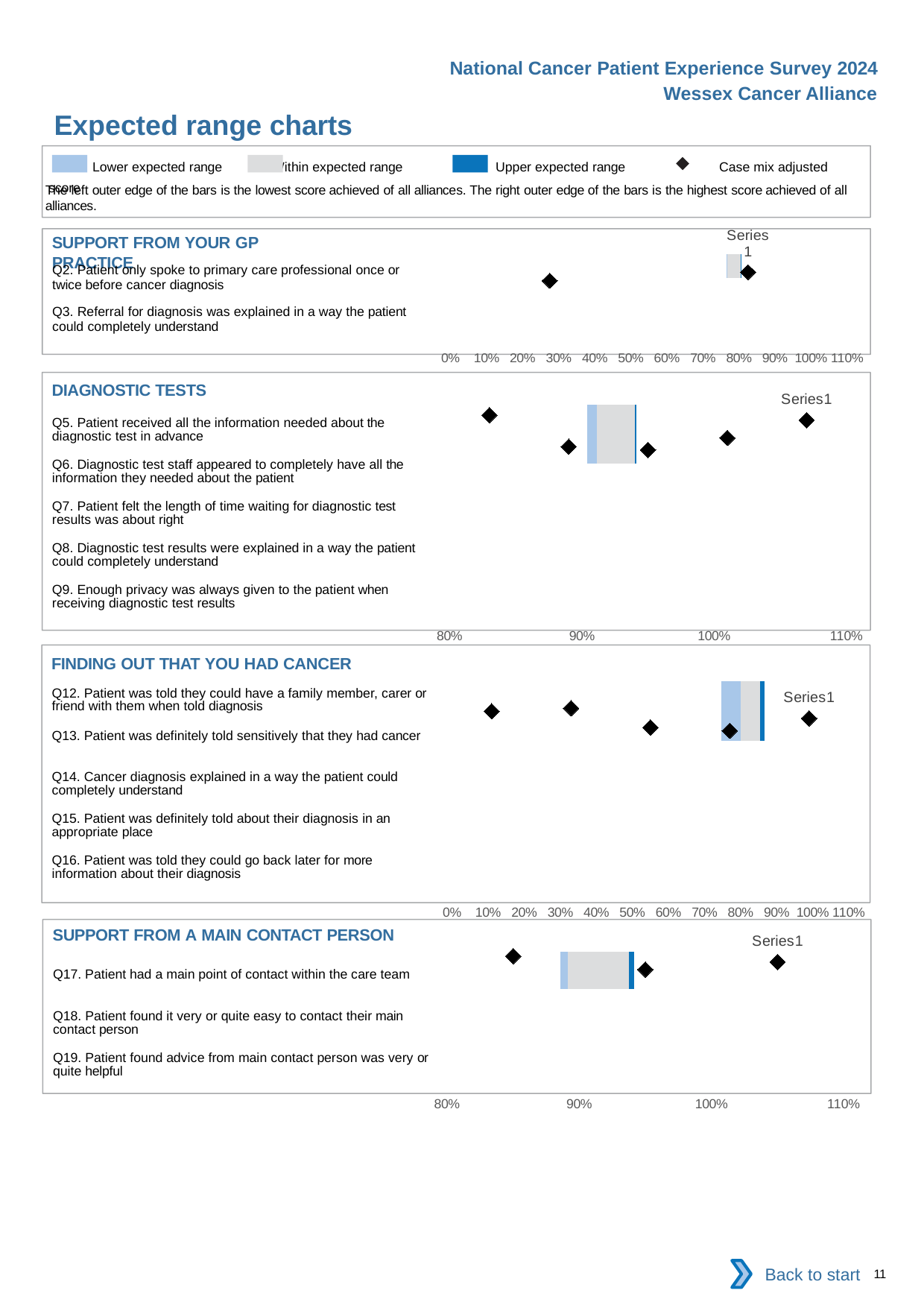
What kind of chart is used in the DIAGNOSTIC TESTS section? bar chart What is the lowest value shown on the x axis of the SUPPORT FROM A MAIN CONTACT PERSON chart? 80% In the FINDING OUT THAT YOU HAD CANCER chart, is the lowest plotted diamond marker greater or less than 20%? less How many charts are shown on the slide? 4 How many questions are listed in the SUPPORT FROM A MAIN CONTACT PERSON chart? 3 How many series does the legend of the DIAGNOSTIC TESTS chart list? 1 How many questions are listed in the DIAGNOSTIC TESTS chart? 5 According to the legend at the top of the slide, what symbol represents the case mix adjusted score? a diamond